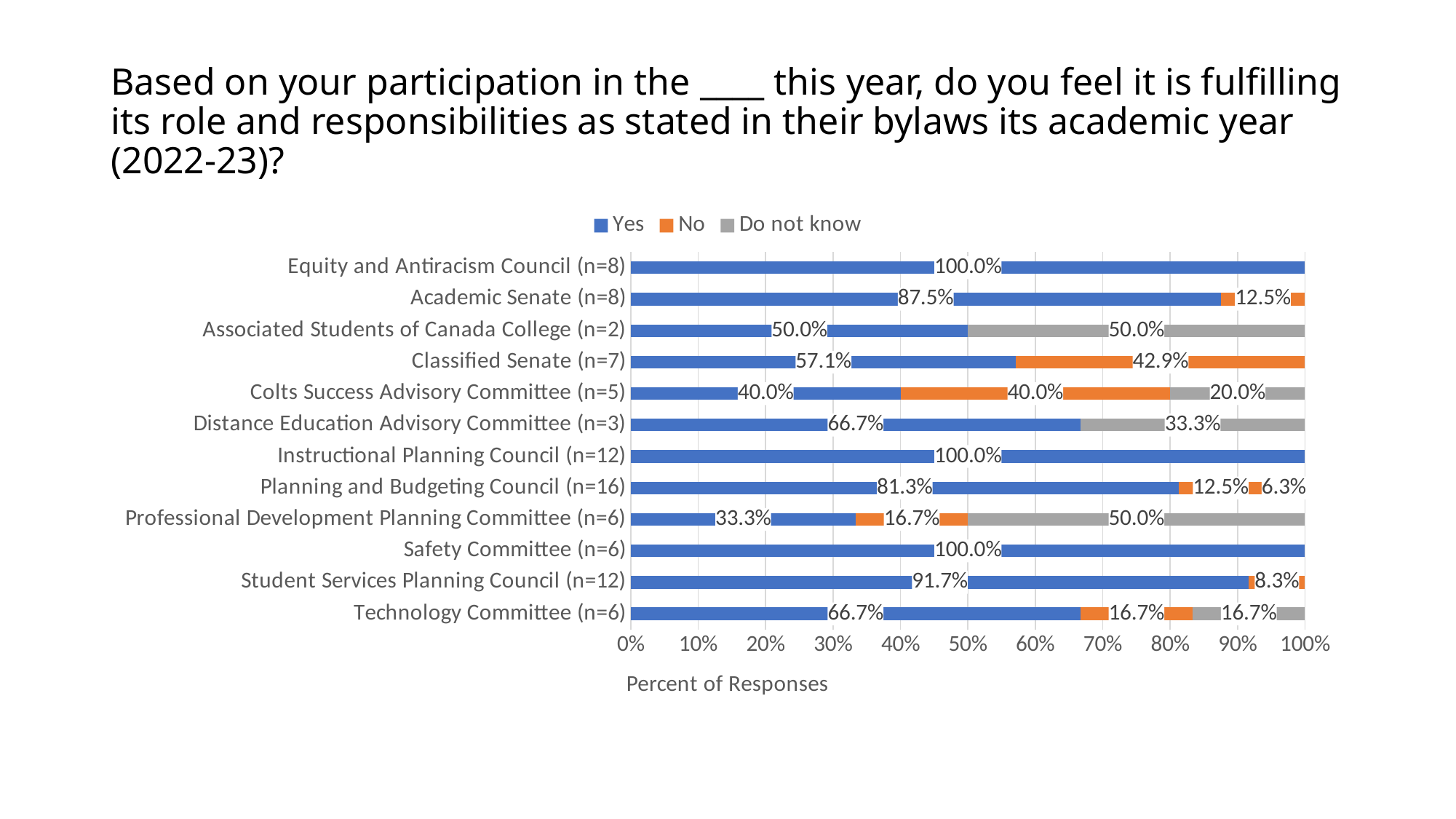
How many series does the legend list? 3 What percentage of Classified Senate (n=7) respondents answered No? 42.9% Which committee or council has the lowest Yes percentage? Professional Development Planning Committee (n=6) What is the difference between the Yes percentage for Student Services Planning Council (n=12) and the Yes percentage for Planning and Budgeting Council (n=16)? 10.4% What kind of chart is shown on the slide? Stacked bar chart Which colour represents the Do not know responses in the chart? Gray How many committees or councils are shown on the chart? 12 What percentage of Professional Development Planning Committee (n=6) respondents answered Do not know? 50.0% What is the label of the horizontal axis? Percent of Responses What percentage of Academic Senate (n=8) respondents answered Yes? 87.5% Which has a larger Yes percentage, Distance Education Advisory Committee (n=3) or Colts Success Advisory Committee (n=5)? Distance Education Advisory Committee (n=3) Which committee or council has the highest No percentage? Classified Senate (n=7)